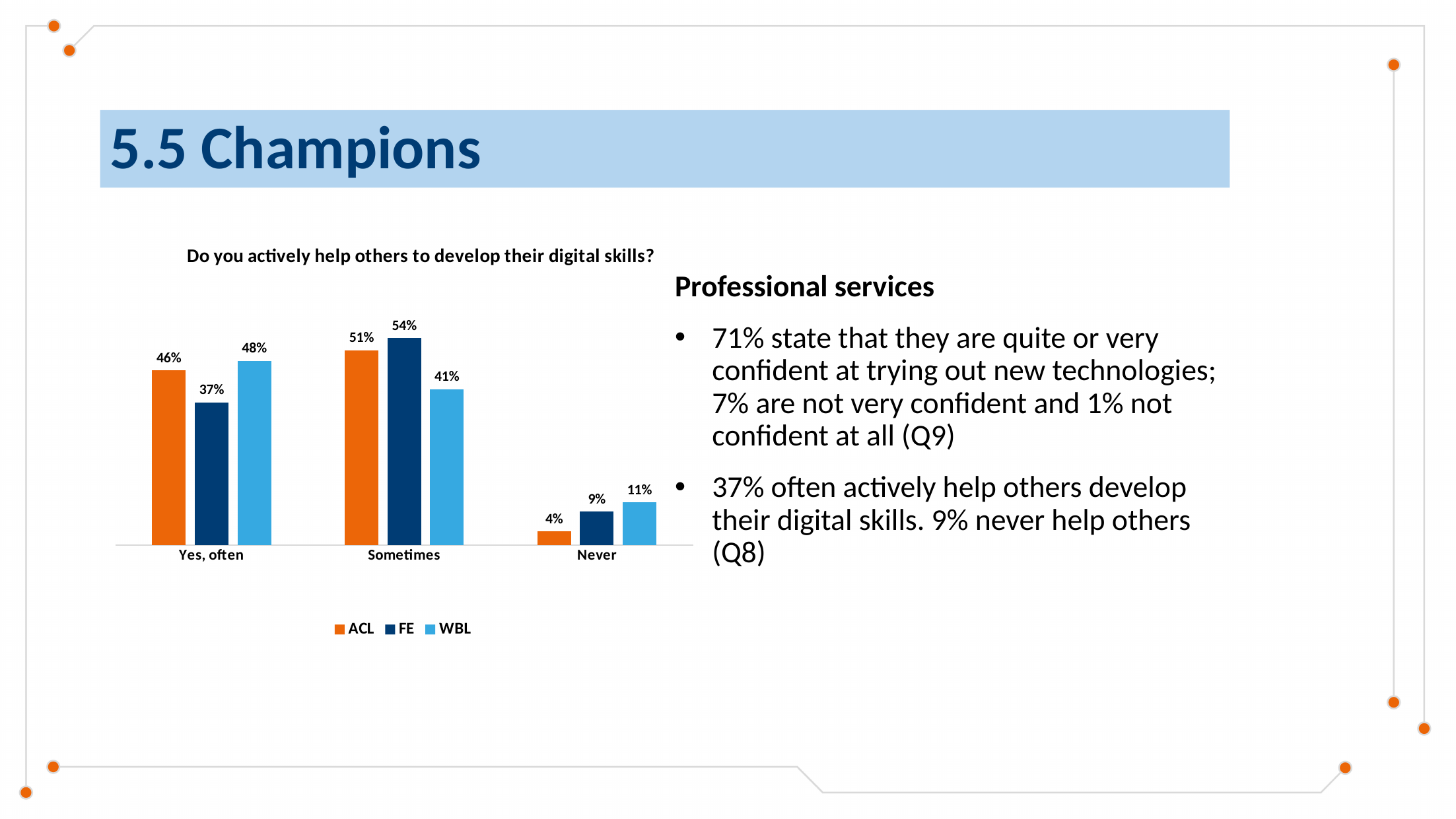
Which category has the highest FE value? Sometimes How many series does the legend list? 3 How many categories are shown on the x axis? 3 What kind of chart is shown? Bar chart What is the ACL value for "Yes, often"? 46% What is the difference between the WBL and FE values for "Yes, often"? 11% Which series is shown in orange? ACL What is the WBL value for "Never"? 11% What is the title of the chart? Do you actively help others to develop their digital skills? Which category has the lowest ACL value? Never What is the FE value for "Sometimes"? 54% Which is larger for "Sometimes": the ACL value or the WBL value? ACL